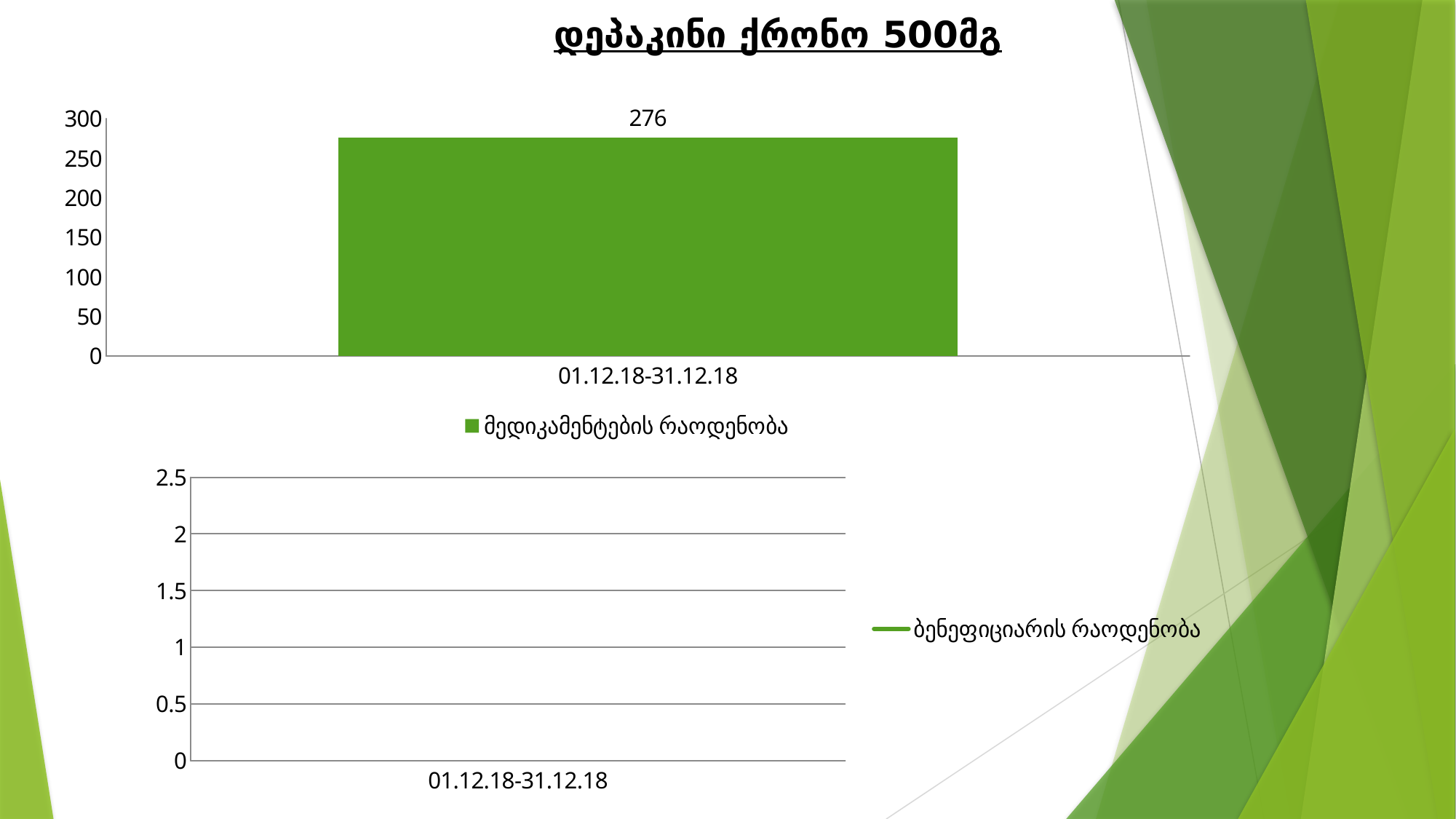
How many series does the legend of the bottom chart list? 1 In the top chart, is the value for 01.12.18-31.12.18 greater or less than 300? less What is the highest tick value on the y axis of the bottom chart? 2.5 What is the category label on the x axis of the top chart? 01.12.18-31.12.18 What is the category label on the x axis of the bottom chart? 01.12.18-31.12.18 What is the title shown above the charts on the slide? დეპაკინი ქრონო 500მგ What kind of chart is the top chart on the slide? bar chart In the top chart, is the value for 01.12.18-31.12.18 greater or less than 250? greater How many bars are plotted in the top chart? 1 In the top chart, what is the value of the bar for 01.12.18-31.12.18? 276 What series name does the legend of the bottom chart show? ბენეფიციარის რაოდენობა How many series does the legend of the top chart list? 1